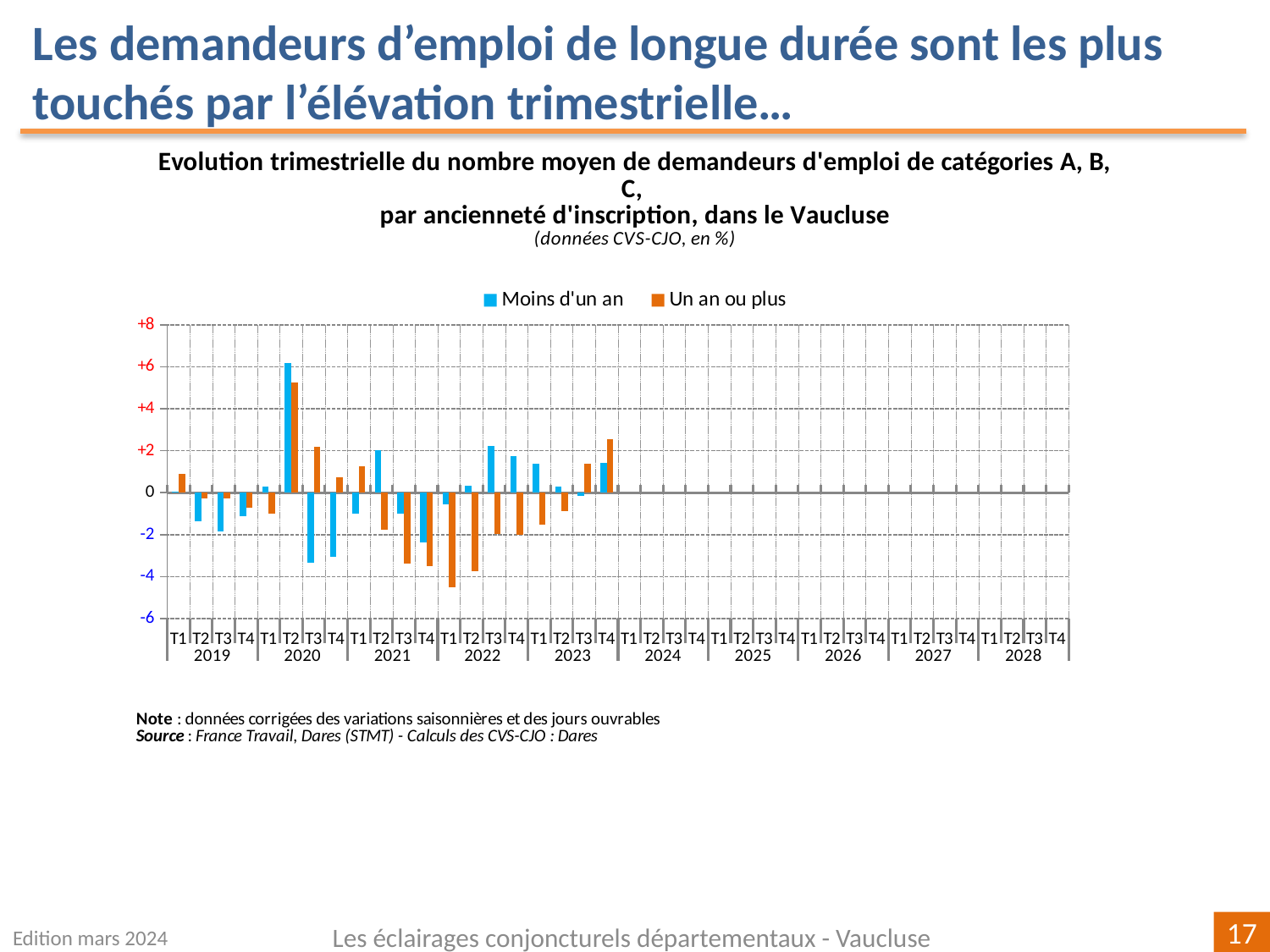
Which colour represents the series 'Un an ou plus'? Orange How many series does the legend list? 2 How many years are labelled along the x axis? 10 In T2 2020, which series has the larger value, 'Moins d'un an' or 'Un an ou plus'? Moins d'un an What kind of chart is shown on the slide? Bar chart What are the two series named in the legend? Moins d'un an; Un an ou plus Is the value for 'Moins d'un an' in T3 2020 greater or less than -2? less In which quarter does the 'Moins d'un an' series reach its highest value? T2 2020 Is the value for 'Moins d'un an' in T2 2020 greater or less than +4? greater Is the value for 'Un an ou plus' in T1 2022 greater or less than -4? less In which quarter does the 'Un an ou plus' series reach its lowest value? T1 2022